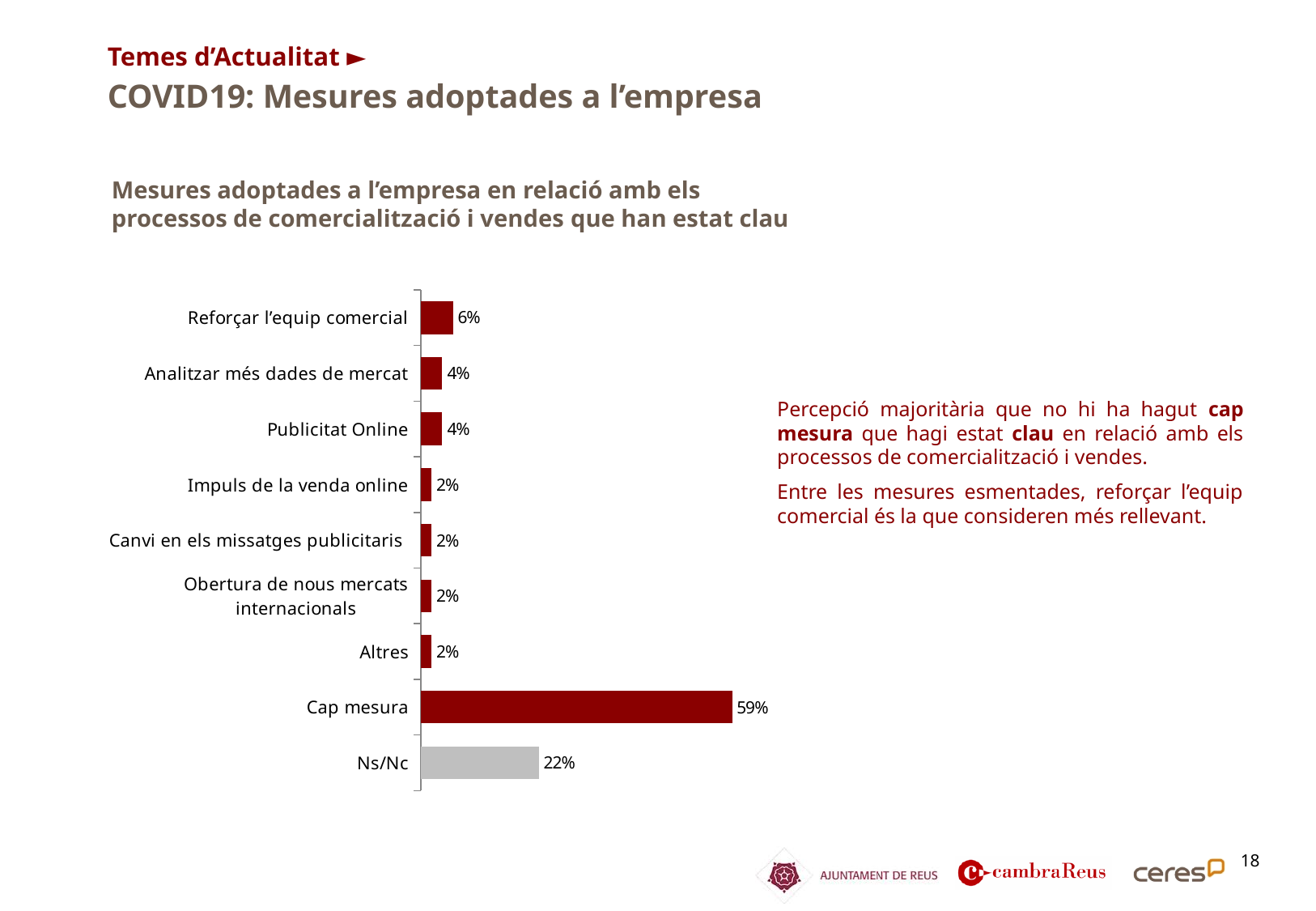
What is the value for Reforçar l'equip comercial? 6% How many categories have a value of 2%? 4 How many categories are shown in the chart? 9 What is the difference between Reforçar l'equip comercial and Analitzar més dades de mercat? 2% Which is larger, Reforçar l'equip comercial or Impuls de la venda online? Reforçar l'equip comercial What is the value for Cap mesura? 59% What kind of chart is shown on the slide? Bar chart Which category has the highest value? Cap mesura What is the difference between Cap mesura and Ns/Nc? 37% Which bar is shown in grey rather than dark red? Ns/Nc What is the value for Ns/Nc? 22% What is the value for Publicitat Online? 4%